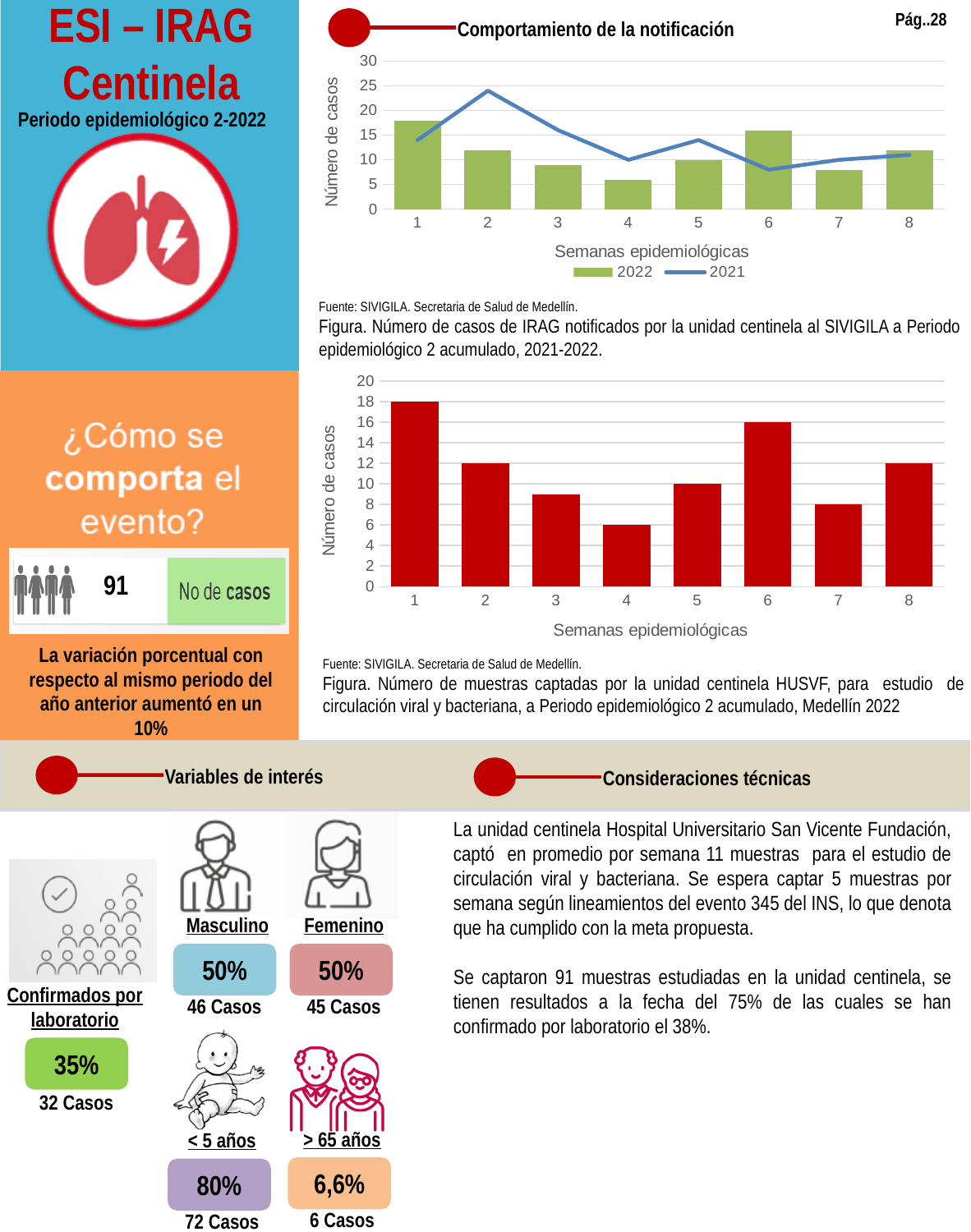
In the bottom chart (Número de muestras captadas), which epidemiological week has the highest number of cases? 1 In the bottom chart (Número de muestras captadas), which epidemiological week has the lowest number of cases? 4 In the bottom chart (Número de muestras captadas), how many epidemiological weeks are plotted? 8 In the bottom chart (Número de muestras captadas), what is the difference between the values for week 1 and week 4? 12 In the bottom chart (Número de muestras captadas), what is the value for week 4? 6 What kind of chart is the bottom chart (Número de muestras captadas)? bar chart In the top chart (Comportamiento de la notificación), is the 2021 value for week 2 greater or less than 20? greater In the bottom chart (Número de muestras captadas), do the values rise or fall from week 1 to week 4? fall In the bottom chart (Número de muestras captadas), what is the value for week 1? 18 In the bottom chart (Número de muestras captadas), what is the value for week 6? 16 In the top chart (Comportamiento de la notificación), how many series does the legend list? 2 In the bottom chart (Número de muestras captadas), which is larger, the value for week 6 or the value for week 2? week 6